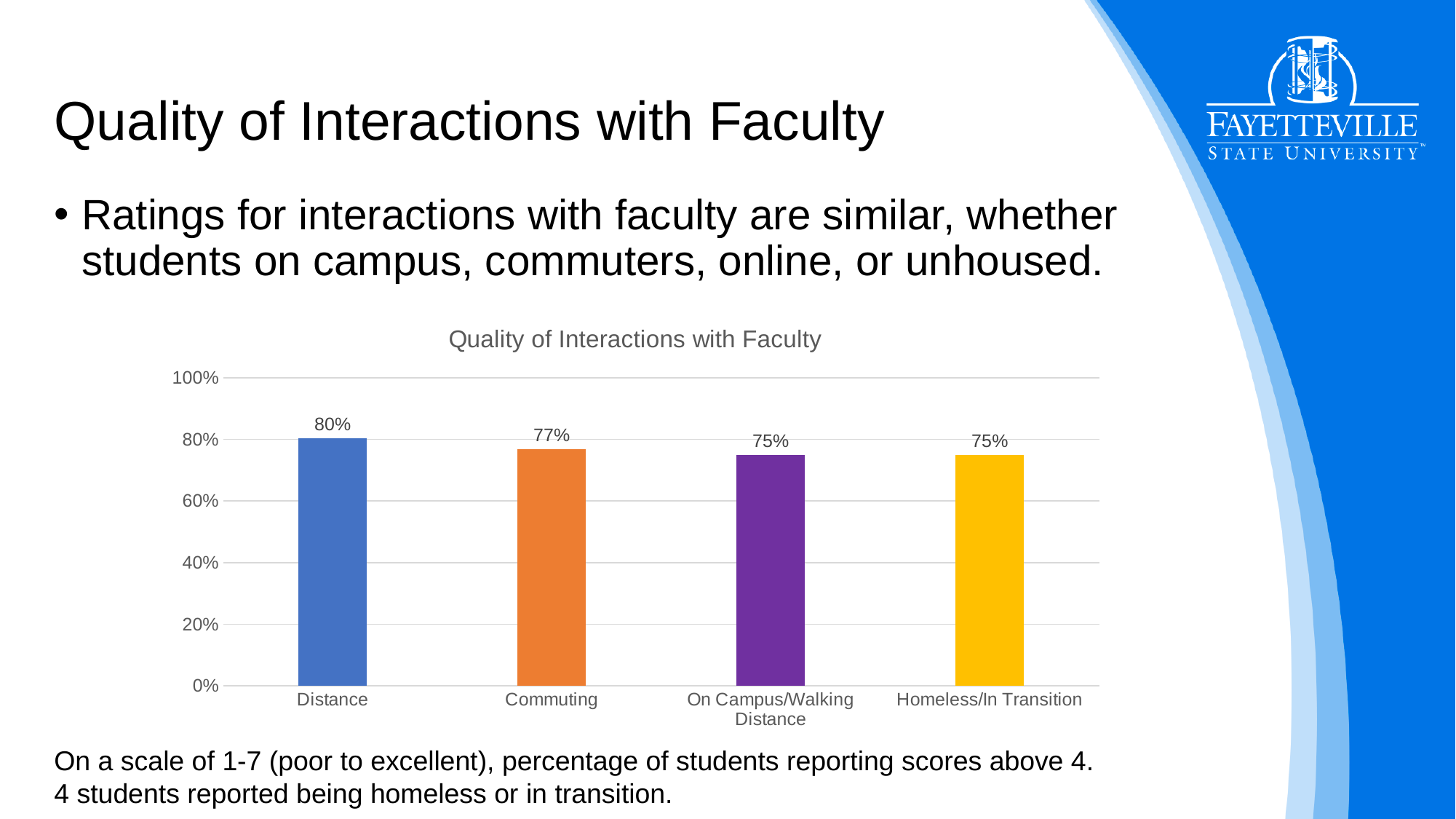
How many categories are shown in the chart? 4 What is the title of the chart? Quality of Interactions with Faculty Is the value for Commuting greater or less than 60%? greater What is the value for Commuting? 77% What is the value for Distance? 80% What is the difference between the values for Distance and Homeless/In Transition? 5% Which category has the highest value? Distance What kind of chart is shown on the slide? Bar chart Which is larger, the value for Commuting or the value for On Campus/Walking Distance? Commuting What is the difference between the values for Distance and Commuting? 3% What is the value for On Campus/Walking Distance? 75% What is the value for Homeless/In Transition? 75%